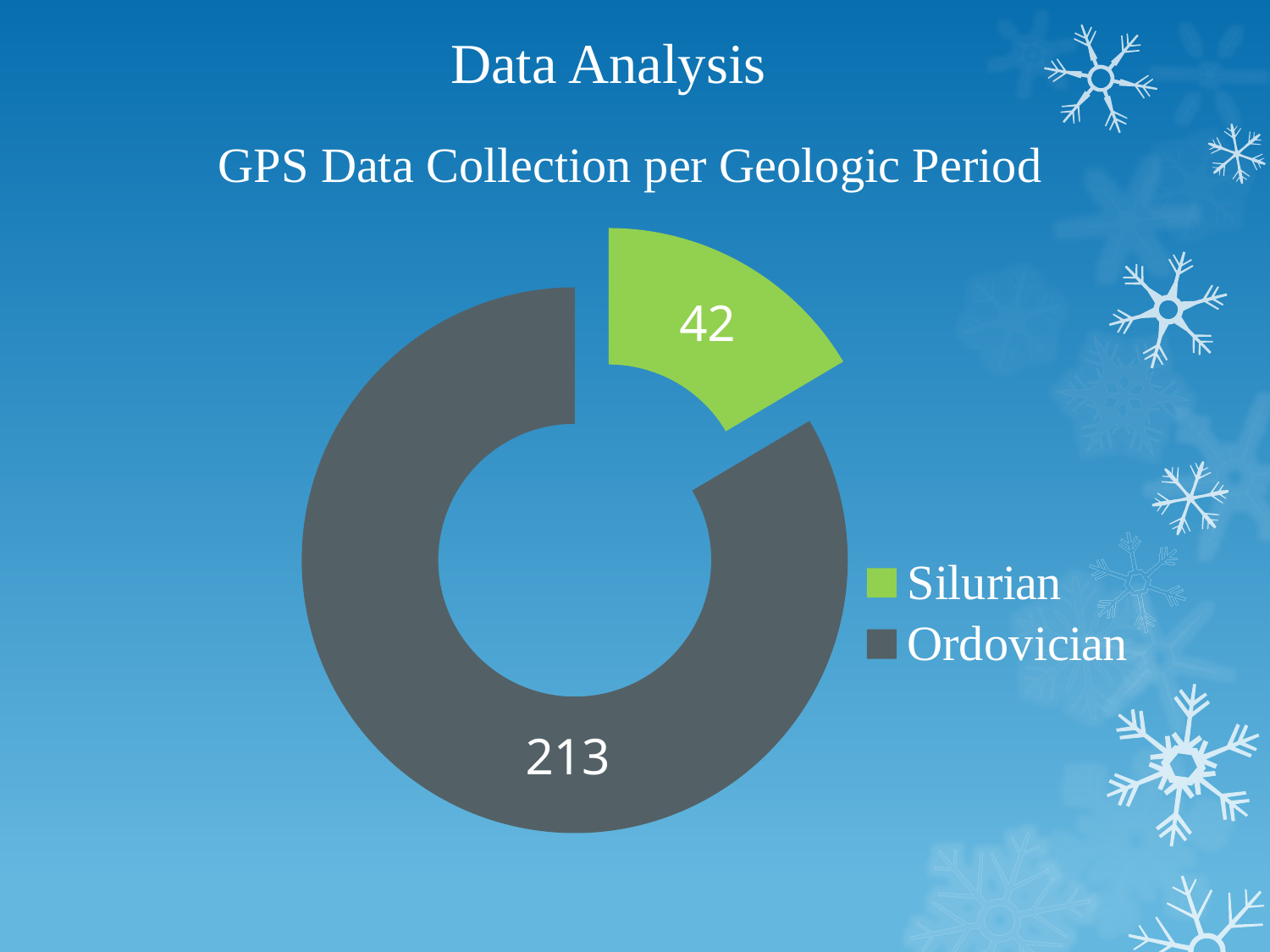
Which geologic period has the lowest value? Silurian What colour represents Silurian in the chart? Green What is the value for Silurian? 42 What kind of chart is shown on the slide? Doughnut chart How many categories does the chart show? 2 What is the total of the two values shown in the chart? 255 What is the title of the chart? GPS Data Collection per Geologic Period Which is larger, the value for Silurian or the value for Ordovician? Ordovician What is the difference between the Ordovician and Silurian values? 171 Which geologic period has the highest value? Ordovician What is the value for Ordovician? 213